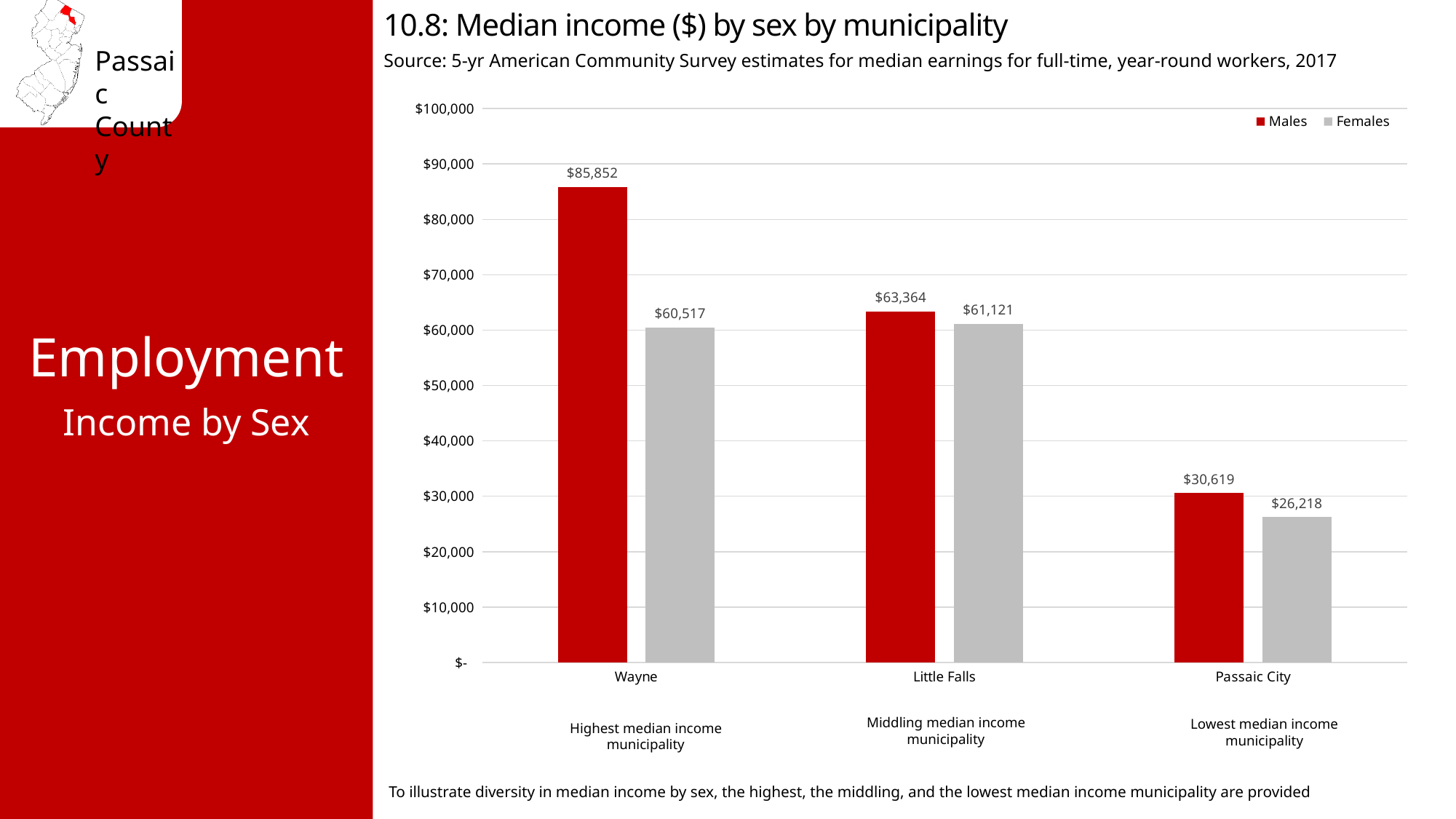
What kind of chart is shown on the slide? Bar chart What is the median income for females in Passaic City? $26,218 Which is larger in Little Falls, the male or the female median income? Males What is the median income for females in Little Falls? $61,121 What is the difference between male and female median income in Passaic City? $4,401 How many series does the legend list? 2 Which municipality has the highest median income for males? Wayne What is the difference between male and female median income in Wayne? $25,335 Is the median income for males in Passaic City greater or less than $40,000? less How many municipalities are shown on the x axis? 3 Which municipality has the lowest median income for females? Passaic City What is the median income for males in Wayne? $85,852